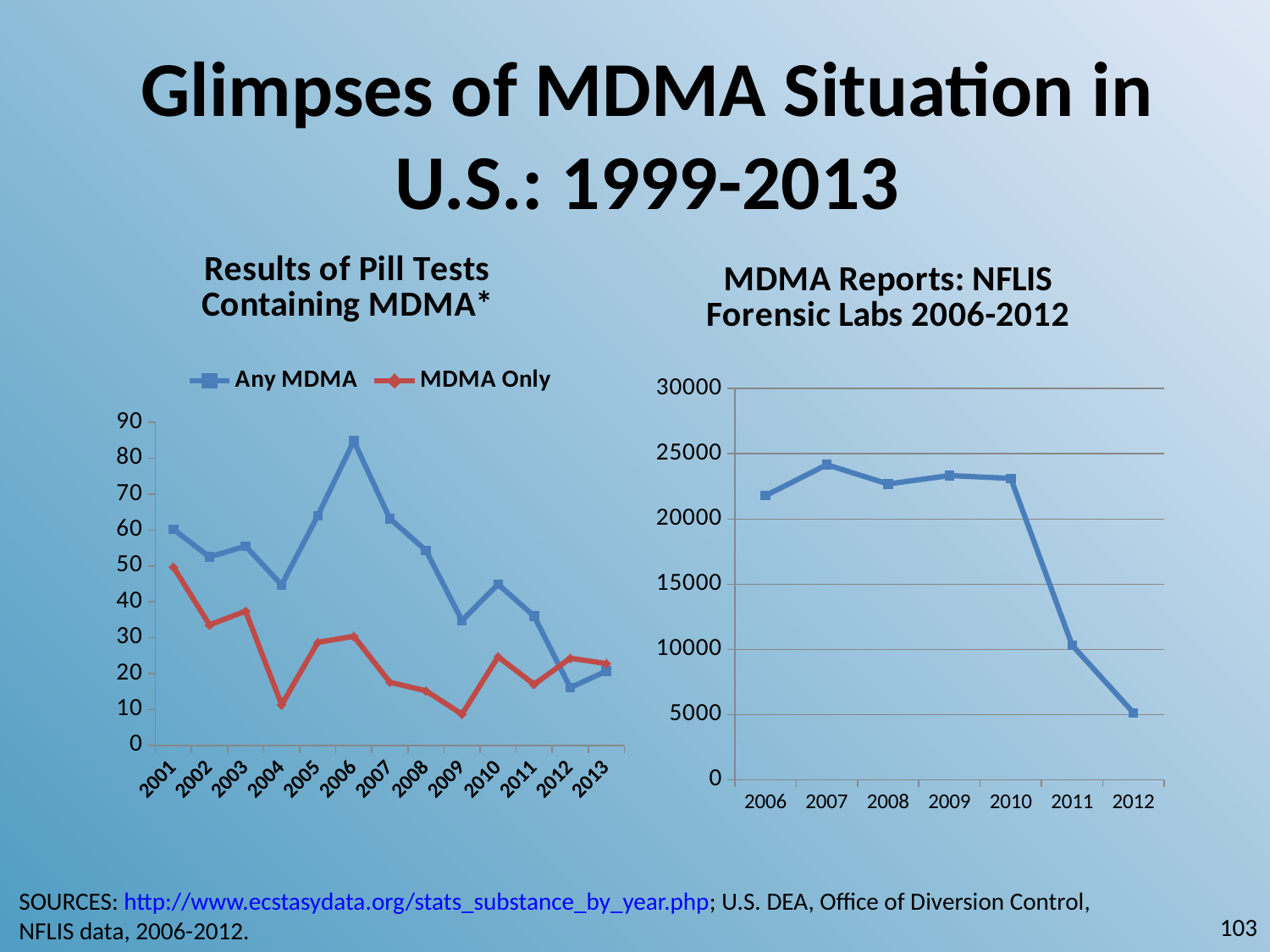
In the 'Results of Pill Tests Containing MDMA*' chart, in which year does the Any MDMA series reach its highest value? 2006 In the 'Results of Pill Tests Containing MDMA*' chart, in which year is the MDMA Only series at its lowest? 2009 What kind of chart is the 'Results of Pill Tests Containing MDMA*' chart? line chart In the 'Results of Pill Tests Containing MDMA*' chart, is the Any MDMA value for 2006 greater or less than 80? greater In the 'Results of Pill Tests Containing MDMA*' chart, which series has the larger value in 2006, Any MDMA or MDMA Only? Any MDMA In the 'Results of Pill Tests Containing MDMA*' chart, in which year does the MDMA Only series have its highest value? 2001 How many years are plotted in the 'MDMA Reports: NFLIS Forensic Labs 2006-2012' chart? 7 In the 'MDMA Reports: NFLIS Forensic Labs 2006-2012' chart, is the value for 2012 greater or less than 10000? less In the 'MDMA Reports: NFLIS Forensic Labs 2006-2012' chart, which year has the highest value? 2007 How many years are plotted on the x axis of the 'Results of Pill Tests Containing MDMA*' chart? 13 In the 'MDMA Reports: NFLIS Forensic Labs 2006-2012' chart, do the values rise or fall from 2010 to 2012? fall How many series does the legend of the 'Results of Pill Tests Containing MDMA*' chart list? 2